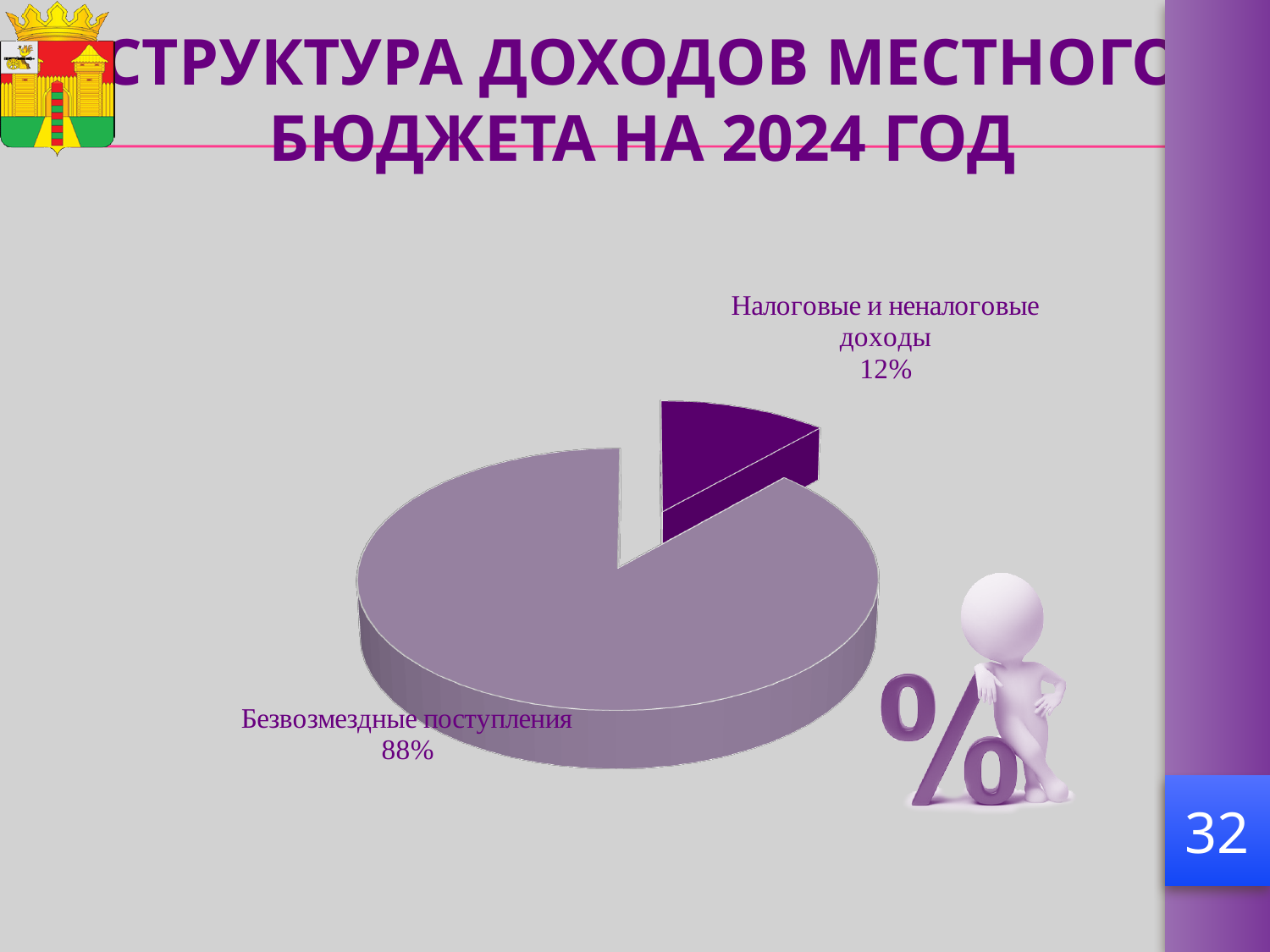
What is the title of the slide containing the pie chart? СТРУКТУРА ДОХОДОВ МЕСТНОГО БЮДЖЕТА НА 2024 ГОД What share of the pie does "Безвозмездные поступления" have? 88% Which is larger: the share for "Безвозмездные поступления" or for "Налоговые и неналоговые доходы"? Безвозмездные поступления How many slices does the pie chart have? 2 What kind of chart is shown on the slide? Pie chart Which category has the smallest slice of the pie? Налоговые и неналоговые доходы Is the share for "Налоговые и неналоговые доходы" greater or less than 50%? less Which category has the largest slice of the pie? Безвозмездные поступления What is the difference in percentage points between "Безвозмездные поступления" and "Налоговые и неналоговые доходы"? 76 percentage points Which slice of the pie is pulled out (exploded) from the rest? Налоговые и неналоговые доходы What share of the pie does "Налоговые и неналоговые доходы" have? 12%